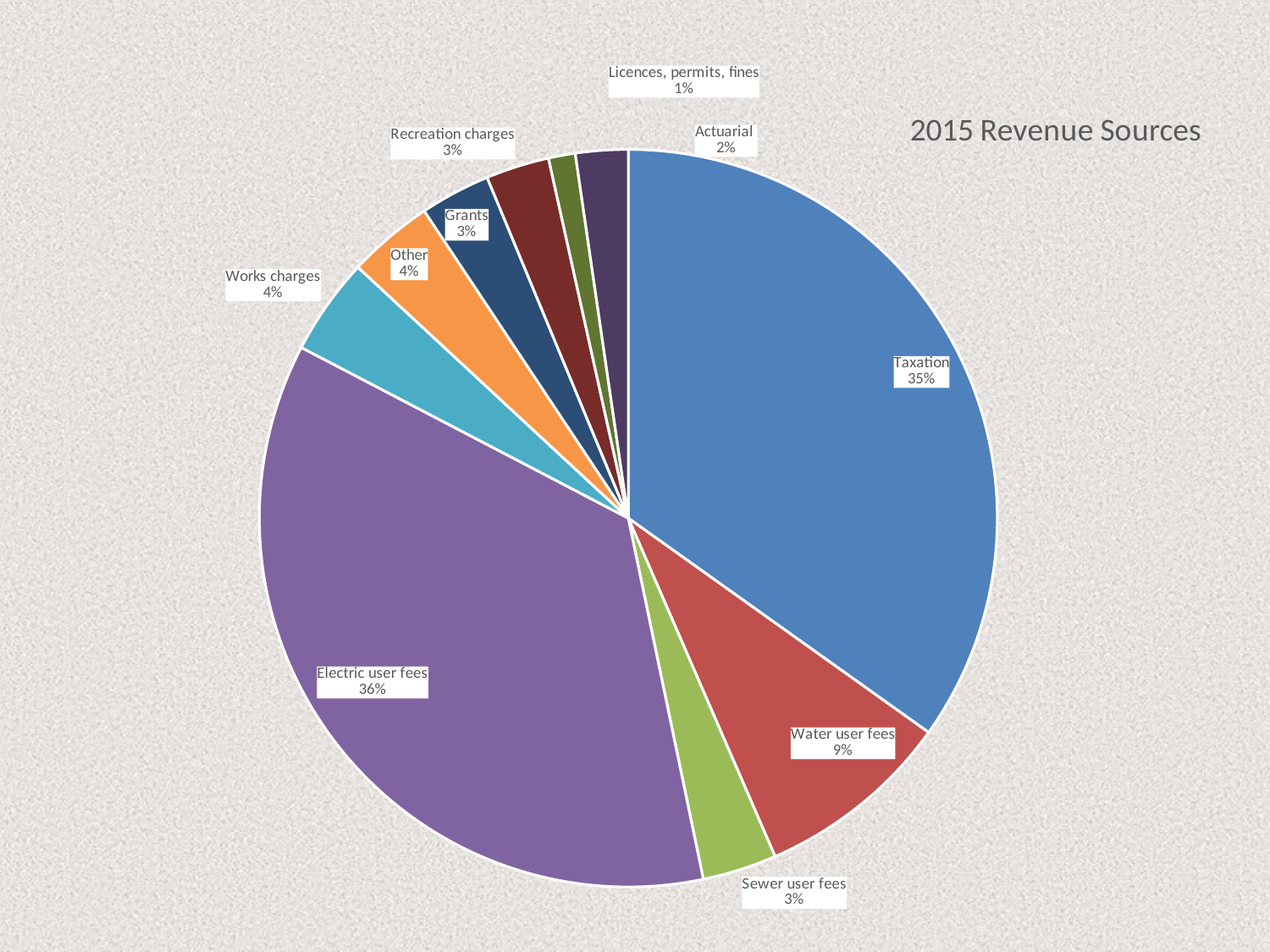
What is the title of the pie chart? 2015 Revenue Sources What percentage of the pie is Electric user fees? 36% What share of 2015 revenue comes from Taxation? 35% How many slices does the pie chart have? 10 What percentage is shown for Works charges? 4% What percentage is shown for Actuarial? 2% What kind of chart is shown on the slide? Pie chart Which is larger, the share for Water user fees or the share for Sewer user fees? Water user fees Which revenue source has the smallest share of the pie? Licences, permits, fines What is the difference in percentage points between Taxation and Water user fees? 26% What is the value shown for Water user fees? 9% Which revenue source has the largest share of the pie? Electric user fees